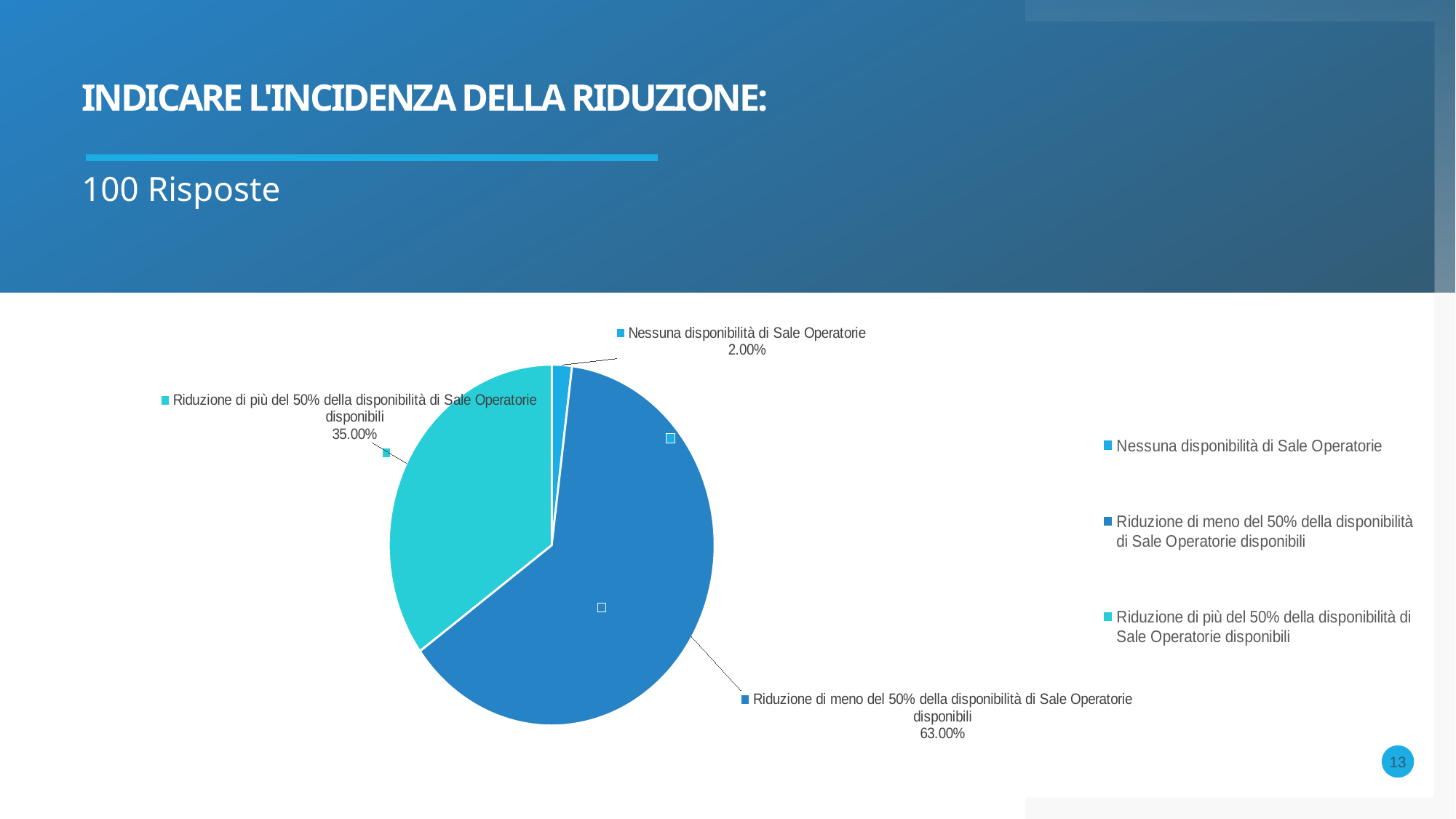
Which category has the largest slice of the pie? Riduzione di meno del 50% della disponibilità di Sale Operatorie disponibili What is the value shown for "Nessuna disponibilità di Sale Operatorie"? 2.00% How many responses does the slide say the chart is based on? 100 Risposte How many slices does the pie chart have? 3 What kind of chart is shown on the slide? pie chart Which is larger: the share for "Riduzione di più del 50%" or for "Nessuna disponibilità di Sale Operatorie"? Riduzione di più del 50% della disponibilità di Sale Operatorie disponibili How many entries does the legend list? 3 What is the difference between the shares for "Riduzione di meno del 50%" and "Riduzione di più del 50%"? 28.00% What share of the pie does "Riduzione di più del 50% della disponibilità di Sale Operatorie disponibili" have? 35.00% What share of the pie does "Riduzione di meno del 50% della disponibilità di Sale Operatorie disponibili" have? 63.00% What is the title of the slide? INDICARE L'INCIDENZA DELLA RIDUZIONE: Which category has the smallest slice of the pie? Nessuna disponibilità di Sale Operatorie